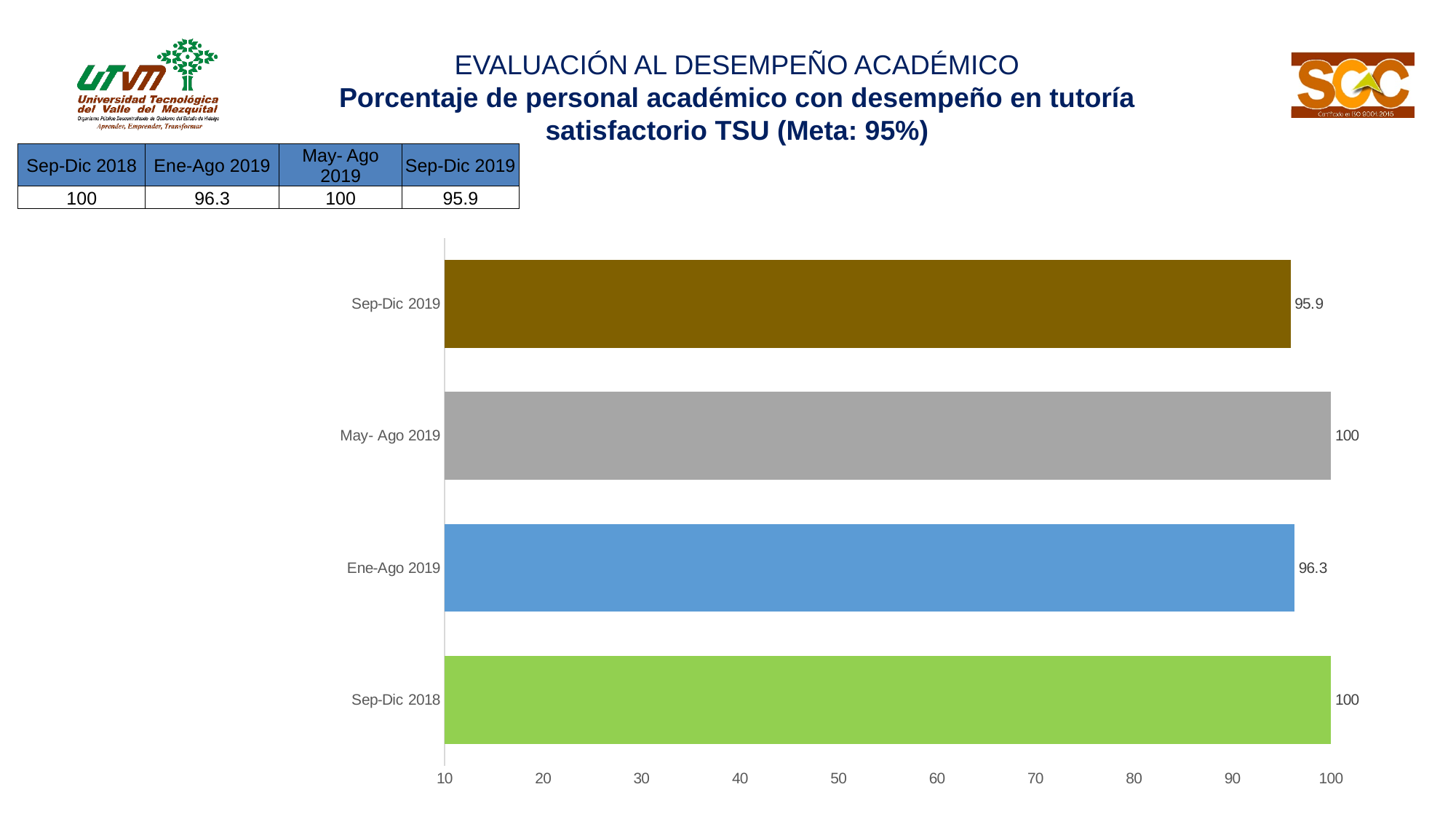
What is the value for Ene-Ago 2019? 96.3 Which period has the lowest value? Sep-Dic 2019 How many periods are shown in the chart? 4 What is the value for Sep-Dic 2018? 100 Is the value for Sep-Dic 2019 greater or less than 90? greater Which is larger, the value for Ene-Ago 2019 or the value for Sep-Dic 2019? Ene-Ago 2019 What is the target (Meta) stated in the chart title? 95% What is the value for Sep-Dic 2019? 95.9 What is the value for May- Ago 2019? 100 What is the difference between the values for May- Ago 2019 and Ene-Ago 2019? 3.7 What kind of chart is shown on the slide? bar chart What is the difference between the values for Ene-Ago 2019 and Sep-Dic 2019? 0.4